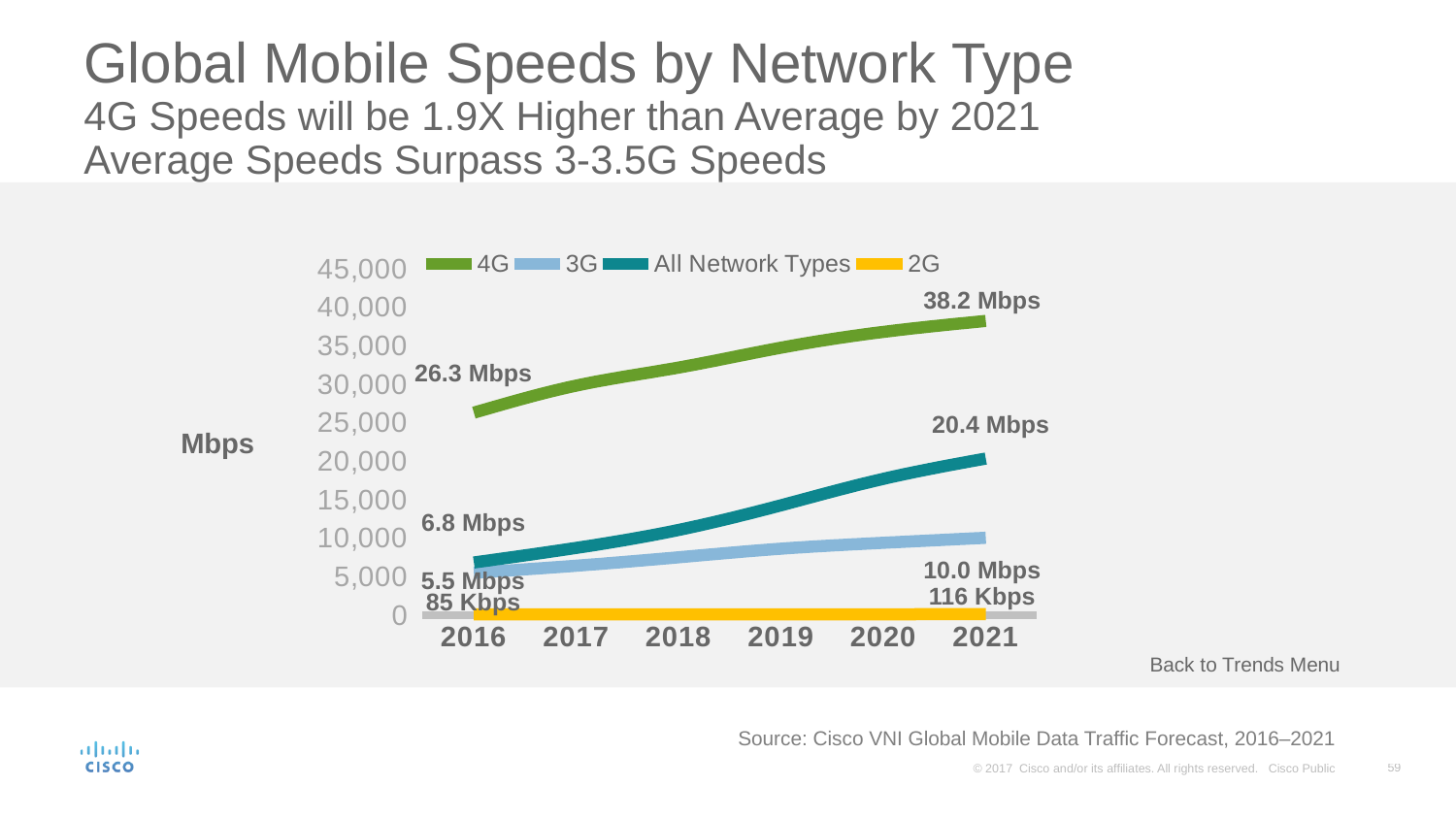
What is the 4G speed shown for 2021? 38.2 Mbps By how much does the 4G speed increase from 2016 to 2021? 11.9 Mbps Which is larger in 2021, the 3G speed or the All Network Types speed? All Network Types By how much does the All Network Types speed increase from 2016 to 2021? 13.6 Mbps What is the 2G speed shown for 2021? 116 Kbps What is the All Network Types speed shown for 2021? 20.4 Mbps Which network type has the highest speed in 2021? 4G Which network type has the lowest speed in 2016? 2G Is the value for 4G in 2018 greater or less than 30,000? greater What is the 4G speed shown for 2016? 26.3 Mbps What is the 3G speed shown for 2016? 5.5 Mbps How many series does the legend list? 4